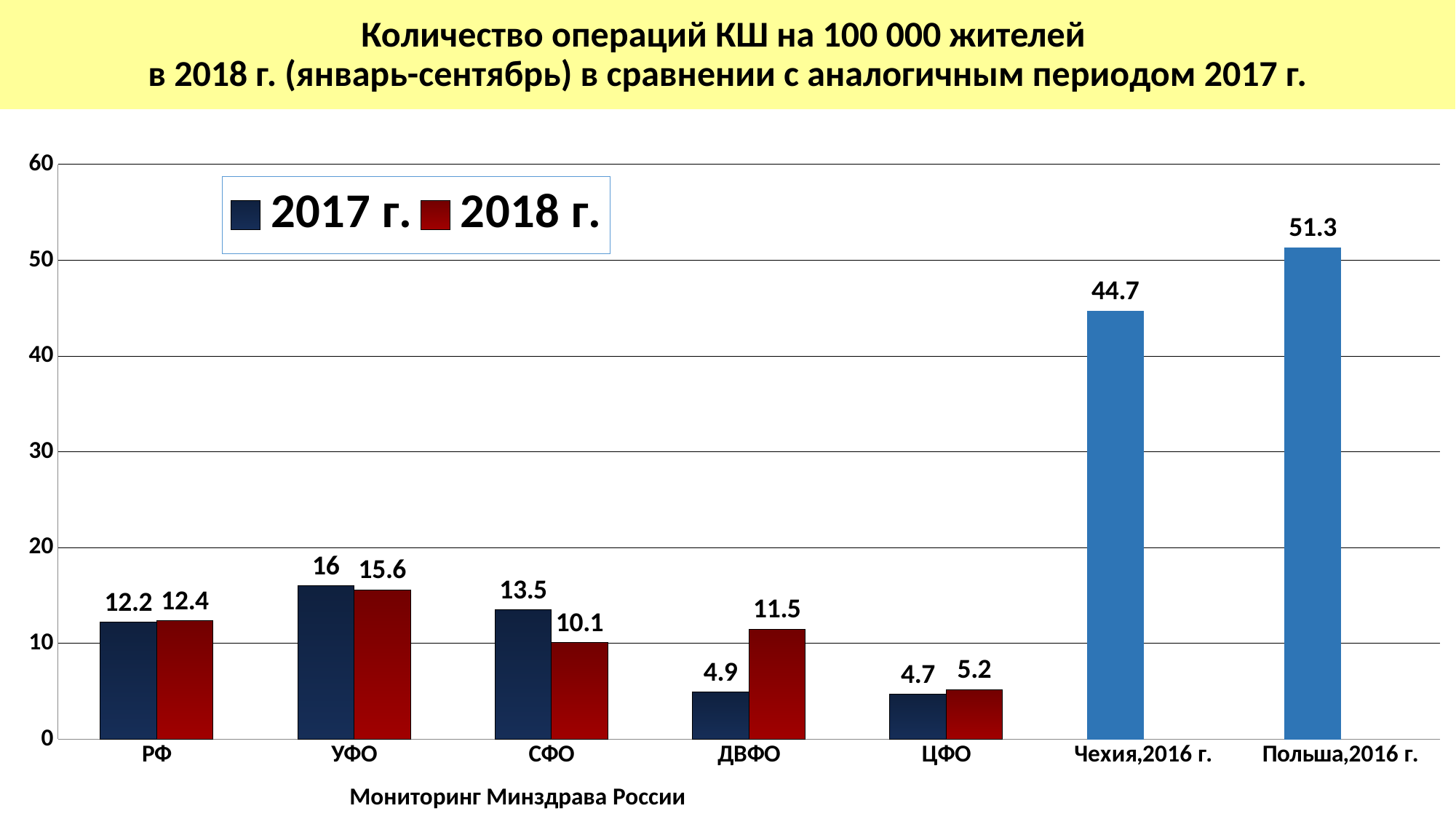
What is the value for СФО in 2018 г.? 10.1 What kind of chart is shown on the slide? Bar chart Which category has the highest value on the chart? Польша,2016 г. Which is larger for ДВФО: the 2017 г. value or the 2018 г. value? 2018 г. Which category has the lowest 2017 г. value? ЦФО What is the value for УФО in 2017 г.? 16 How many categories are shown on the x axis? 7 What is the value for ДВФО in 2018 г.? 11.5 What is the value shown for Польша,2016 г.? 51.3 How many series does the legend list? 2 Is the value for Чехия,2016 г. greater or less than 40? greater What is the difference between the 2017 г. and 2018 г. values for СФО? 3.4